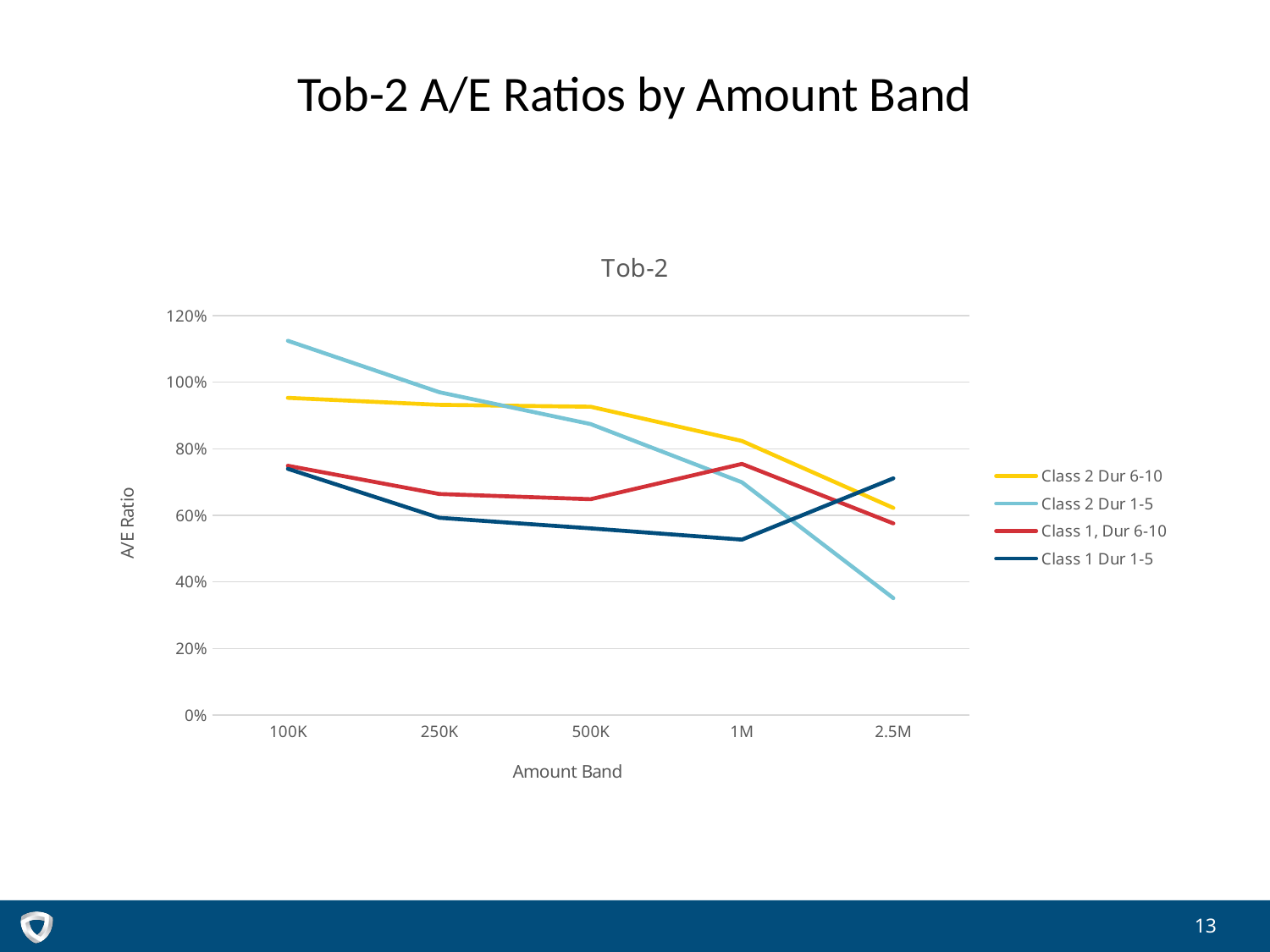
Is the value for Class 2 Dur 1-5 at 2.5M greater or less than 40%? less Is the value for Class 2 Dur 1-5 at 100K greater or less than 100%? greater How many amount bands are shown on the x axis? 5 How many series does the legend list? 4 What is the title of the y axis? A/E Ratio What is the title of the x axis? Amount Band Which series has the highest A/E ratio at the 100K amount band? Class 2 Dur 1-5 Does the Class 2 Dur 1-5 line rise or fall as the amount band increases from 100K to 2.5M? fall Is the value for Class 1 Dur 1-5 at 1M greater or less than 60%? less Which series has the lowest A/E ratio at the 2.5M amount band? Class 2 Dur 1-5 What kind of chart is shown on the slide? line chart At the 500K amount band, which is larger: Class 2 Dur 6-10 or Class 1 Dur 1-5? Class 2 Dur 6-10